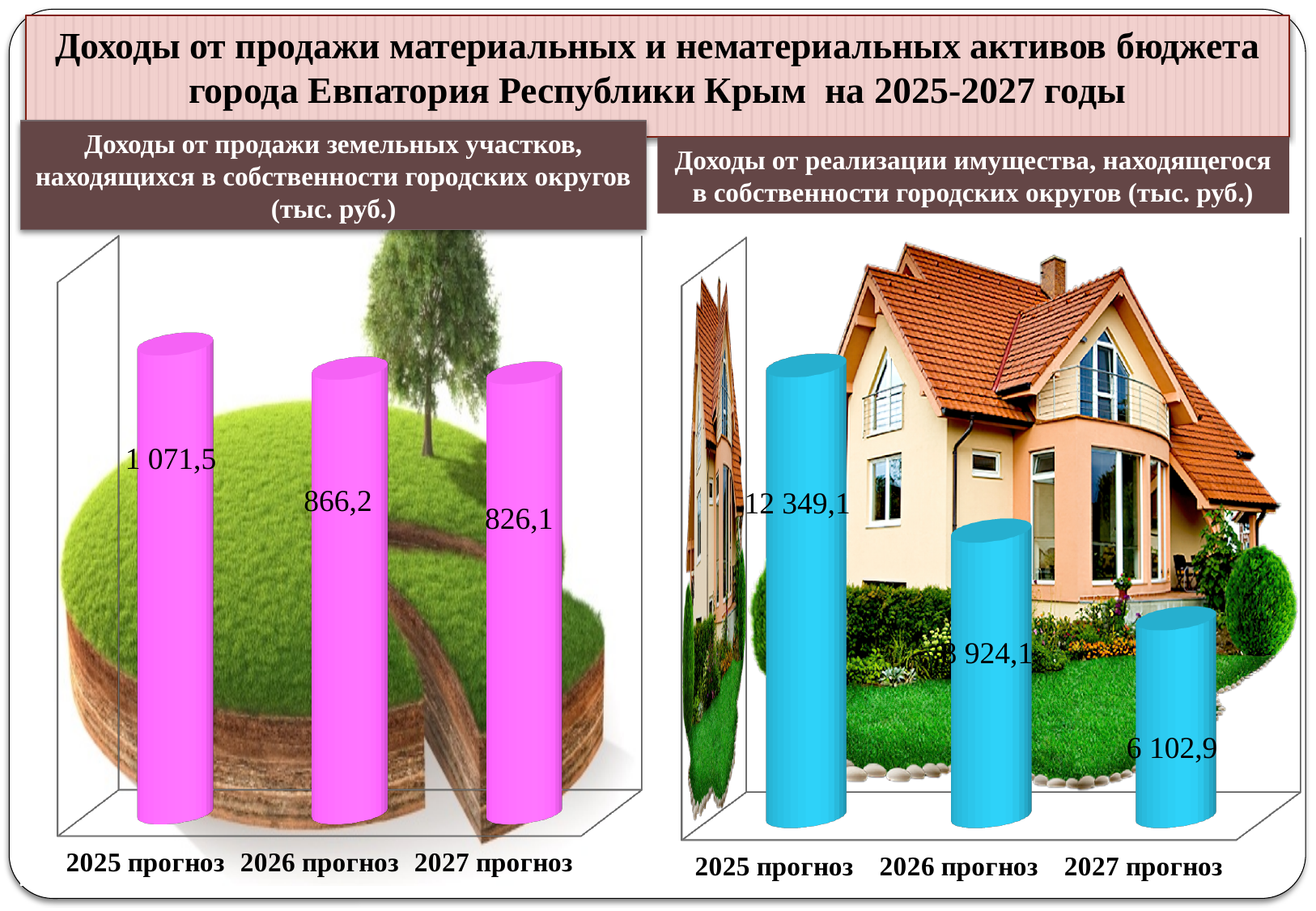
In the left chart (Доходы от продажи земельных участков), what is the value for 2026 прогноз? 866,2 In the left chart (Доходы от продажи земельных участков), what is the difference between the 2025 прогноз and 2026 прогноз values? 205,3 In the left chart (Доходы от продажи земельных участков), what is the value for 2027 прогноз? 826,1 In the right chart (Доходы от реализации имущества), what is the value for 2025 прогноз? 12 349,1 In the right chart (Доходы от реализации имущества), what is the value for 2027 прогноз? 6 102,9 Do the values in the right chart (Доходы от реализации имущества) rise or fall from 2025 to 2027? fall In the left chart (Доходы от продажи земельных участков), what is the value for 2025 прогноз? 1 071,5 How many categories are shown in the left chart (Доходы от продажи земельных участков)? 3 In the right chart (Доходы от реализации имущества), which is larger: the value for 2025 прогноз or 2026 прогноз? 2025 прогноз In the left chart (Доходы от продажи земельных участков), which year has the highest value? 2025 прогноз In the right chart (Доходы от реализации имущества), what is the difference between the 2025 прогноз and 2027 прогноз values? 6 246,2 In the right chart (Доходы от реализации имущества), which year has the lowest value? 2027 прогноз